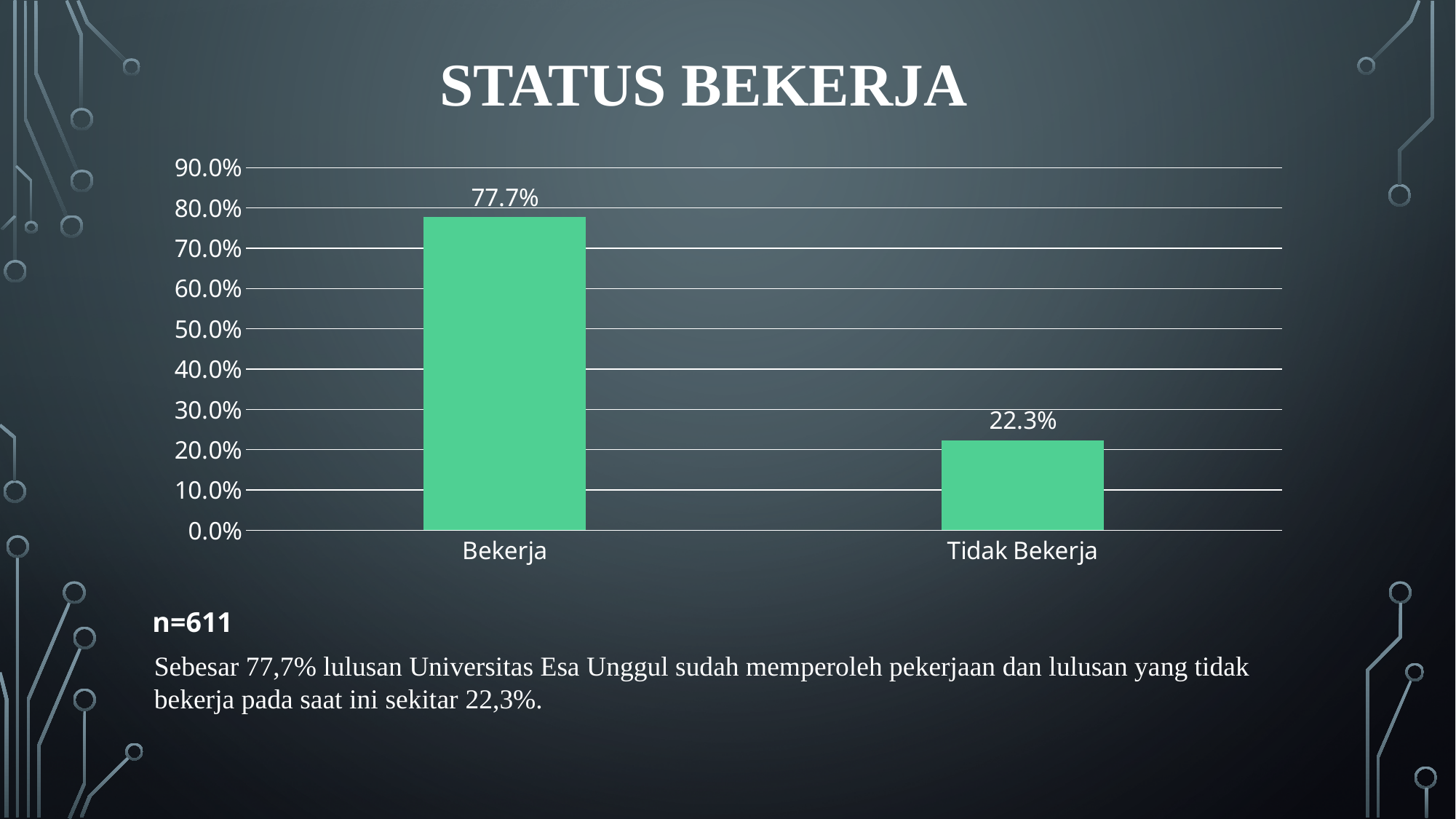
What is the difference between the values for Bekerja and Tidak Bekerja? 55.4% How many categories are shown on the chart? 2 Is the value for Tidak Bekerja greater or less than 30.0%? less What is the value for Tidak Bekerja? 22.3% What kind of chart is shown on the slide? bar chart What is the value for Bekerja? 77.7% Which is larger, the value for Bekerja or the value for Tidak Bekerja? Bekerja What is the highest value shown on the vertical axis? 90.0% Is the value for Bekerja greater or less than 70.0%? greater What is the title of the slide containing the chart? STATUS BEKERJA Which category has the lowest value? Tidak Bekerja Which category has the highest value? Bekerja